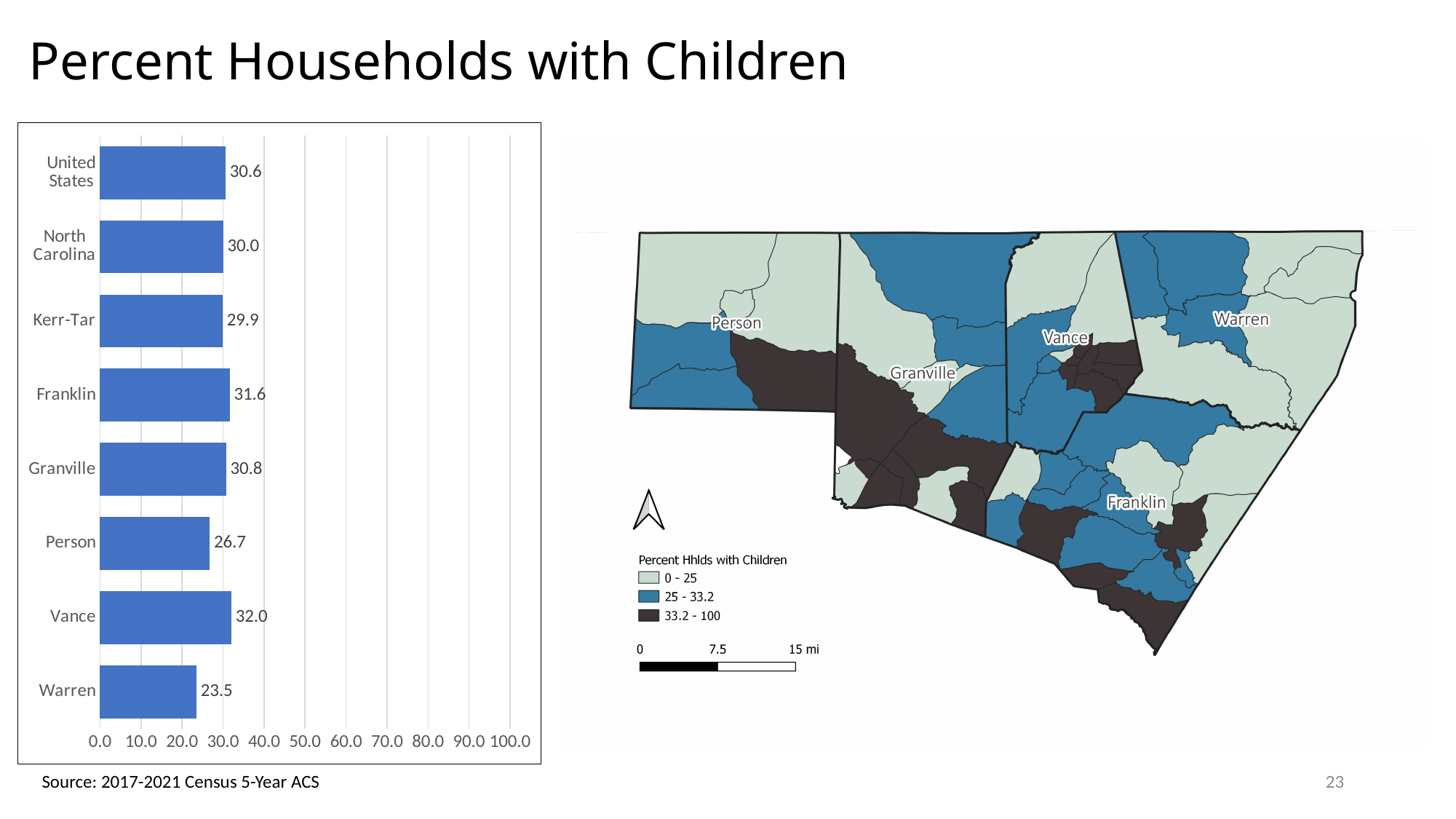
What is the value for Kerr-Tar in the bar chart? 29.9 What is the highest value shown on the x axis of the bar chart? 100.0 What is the value for Vance in the bar chart? 32.0 What is the value for Warren in the bar chart? 23.5 How many categories are shown in the bar chart? 8 Which category has the lowest value in the bar chart? Warren Which category has the highest value in the bar chart? Vance What is the difference between the values for Franklin and Person in the bar chart? 4.9 Which is larger in the bar chart, the value for Granville or the value for North Carolina? Granville What kind of chart is shown on the left of the slide? bar chart Is the value for Person in the bar chart greater or less than 30.0? less What is the value for the United States in the bar chart? 30.6